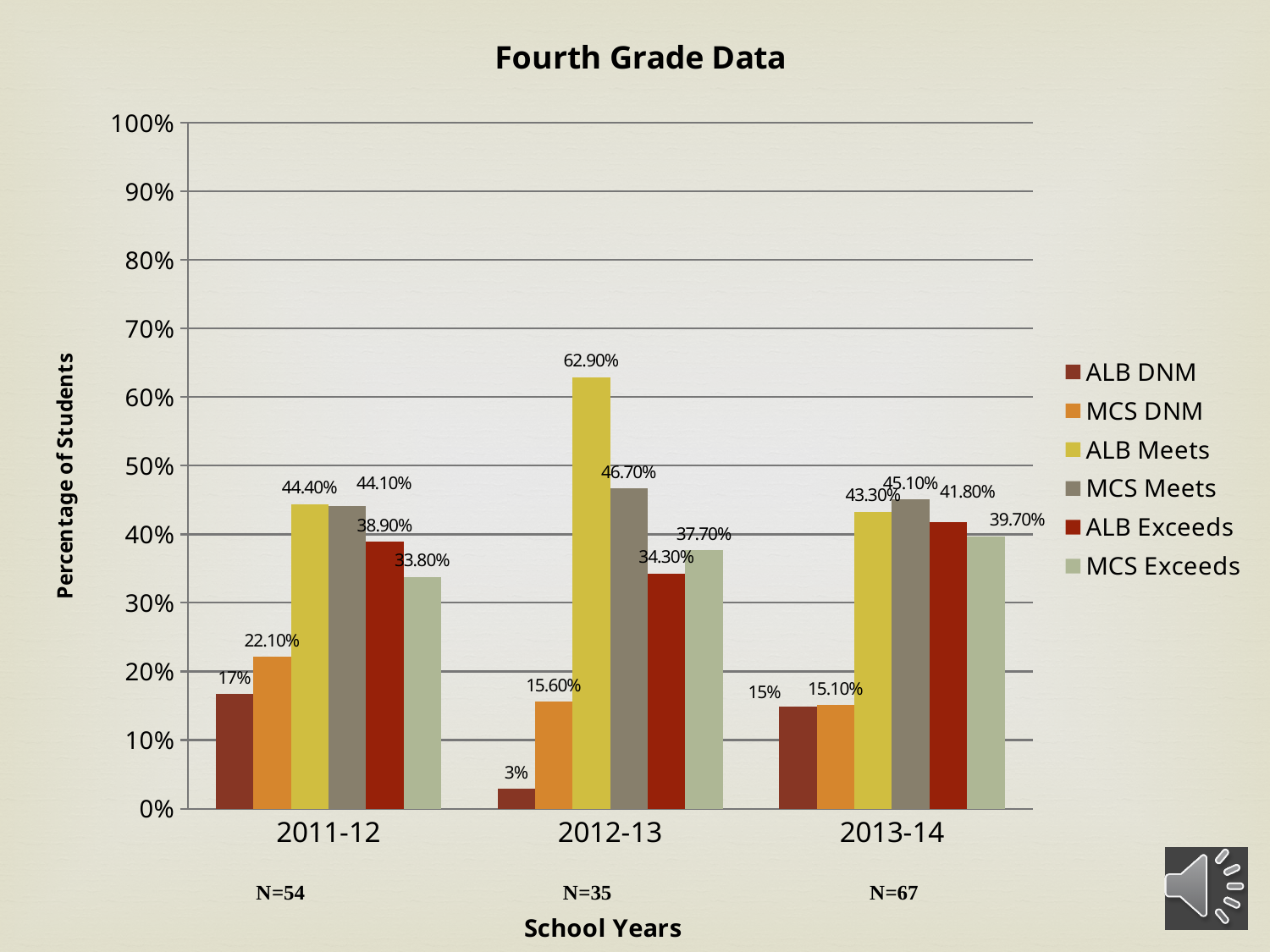
Which is larger in 2013-14, ALB Exceeds or MCS Exceeds? ALB Exceeds What is the value for ALB Meets in 2012-13? 62.90% What is the title of the chart? Fourth Grade Data What is the value for MCS DNM in 2011-12? 22.10% How many series does the legend list? 6 What is the difference between ALB Meets and MCS Meets in 2012-13? 16.20% Which school year has the lowest value for ALB DNM? 2012-13 What type of chart is shown on the slide? bar chart Does the value for ALB DNM rise or fall from 2011-12 to 2012-13? fall How many school years are shown on the x axis? 3 Which series has the highest value in 2012-13? ALB Meets What is the value for ALB Exceeds in 2013-14? 41.80%